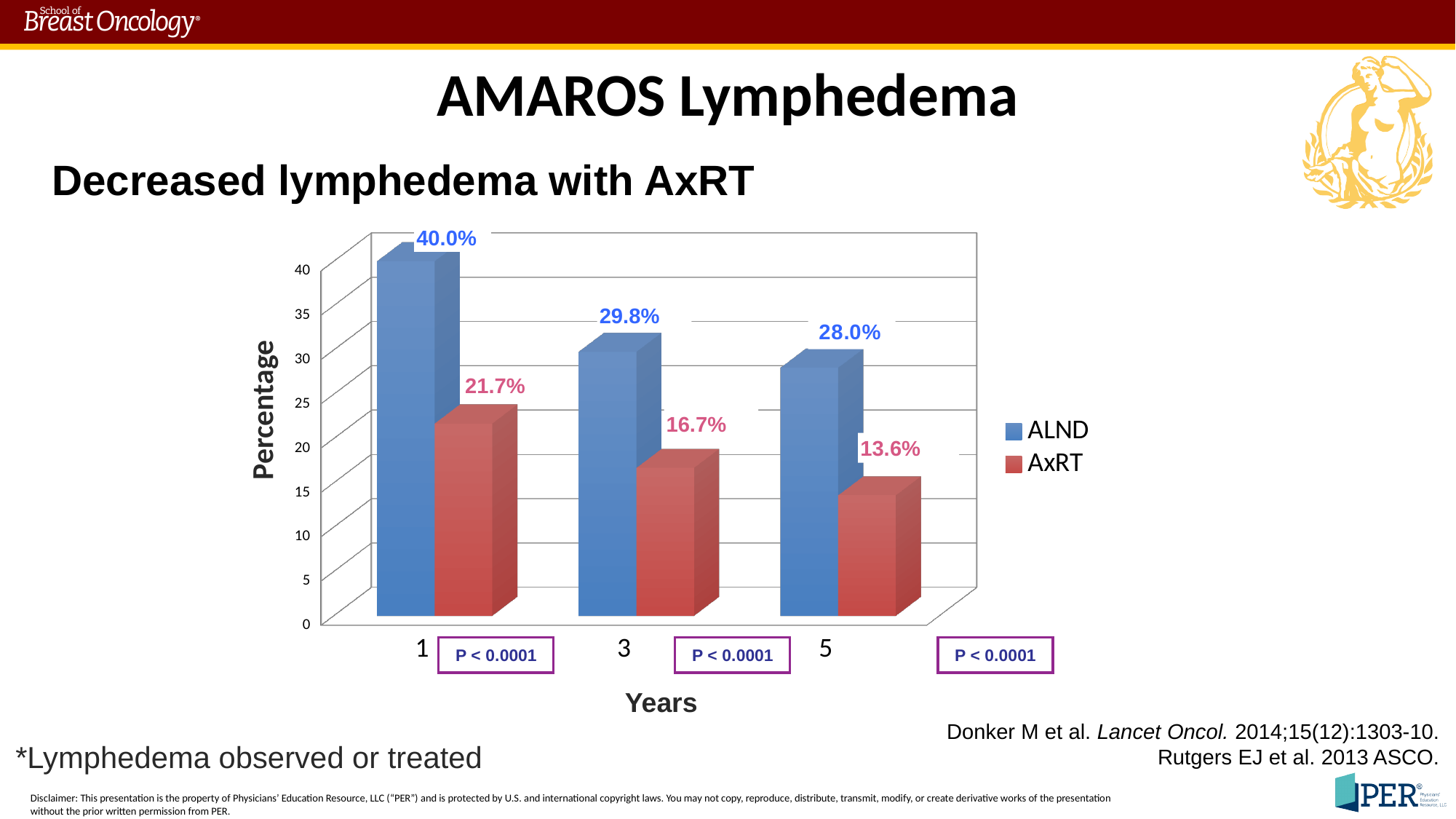
What is the difference between the ALND and AxRT percentages at year 1? 18.3% What is the lymphedema percentage for ALND at year 1? 40.0% Which is larger at year 3, the ALND value or the AxRT value? ALND How many series does the legend list? 2 How many year categories are shown on the x axis? 3 What is the lymphedema percentage for AxRT at year 3? 16.7% Do the ALND values rise or fall from year 1 to year 5? Fall What is the lymphedema percentage for AxRT at year 5? 13.6% At which year is the ALND lymphedema percentage highest? 1 What kind of chart is shown on the slide? Bar chart At which year is the AxRT lymphedema percentage lowest? 5 What is the label of the y axis? Percentage